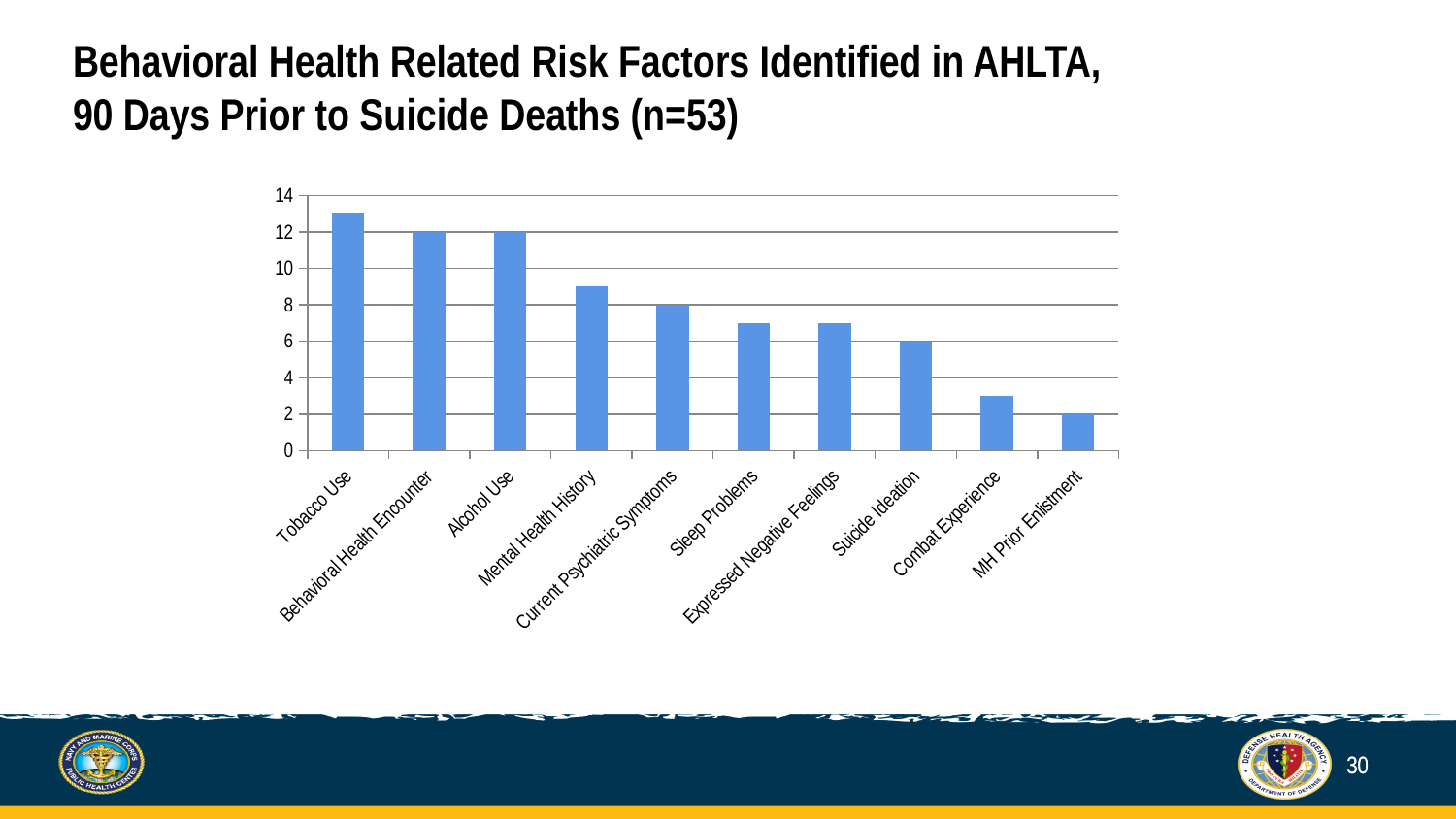
Which risk factor has the lowest value on the chart? MH Prior Enlistment What is the value for Current Psychiatric Symptoms? 8 Which risk factor has the highest value on the chart? Tobacco Use Do the values rise or fall moving from left to right along the x axis? Fall What type of chart is shown on the slide? Bar chart What is the value for MH Prior Enlistment? 2 What is the value for Suicide Ideation? 6 Is the value for Tobacco Use greater or less than 12? greater What is the value for Behavioral Health Encounter? 12 What is the difference between the values for Alcohol Use and Suicide Ideation? 6 Which is larger, the value for Mental Health History or the value for Combat Experience? Mental Health History How many risk factor categories are plotted on the chart? 10